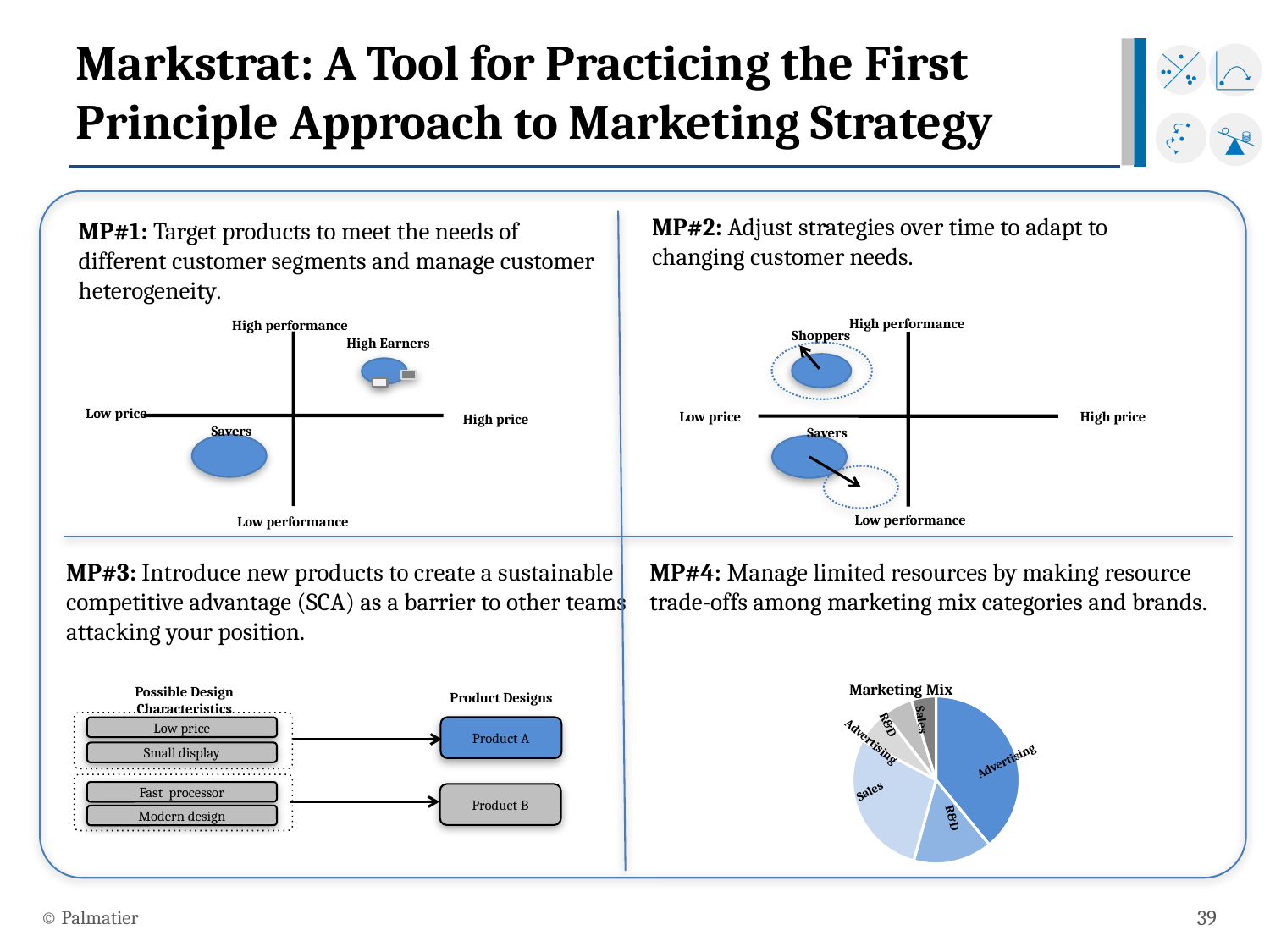
Does the Marketing Mix pie chart display percentage values on its slices? No How many distinct category names are used to label the slices of the Marketing Mix pie chart? 3 How many slices does the Marketing Mix pie chart have? 6 What is the title of the pie chart under MP#4? Marketing Mix What kind of chart is shown under MP#4 on the slide? pie chart Which slice is the largest in the Marketing Mix pie chart? Advertising In the Marketing Mix pie chart, which is larger: the large dark blue Advertising slice or the R&D slice next to it? Advertising